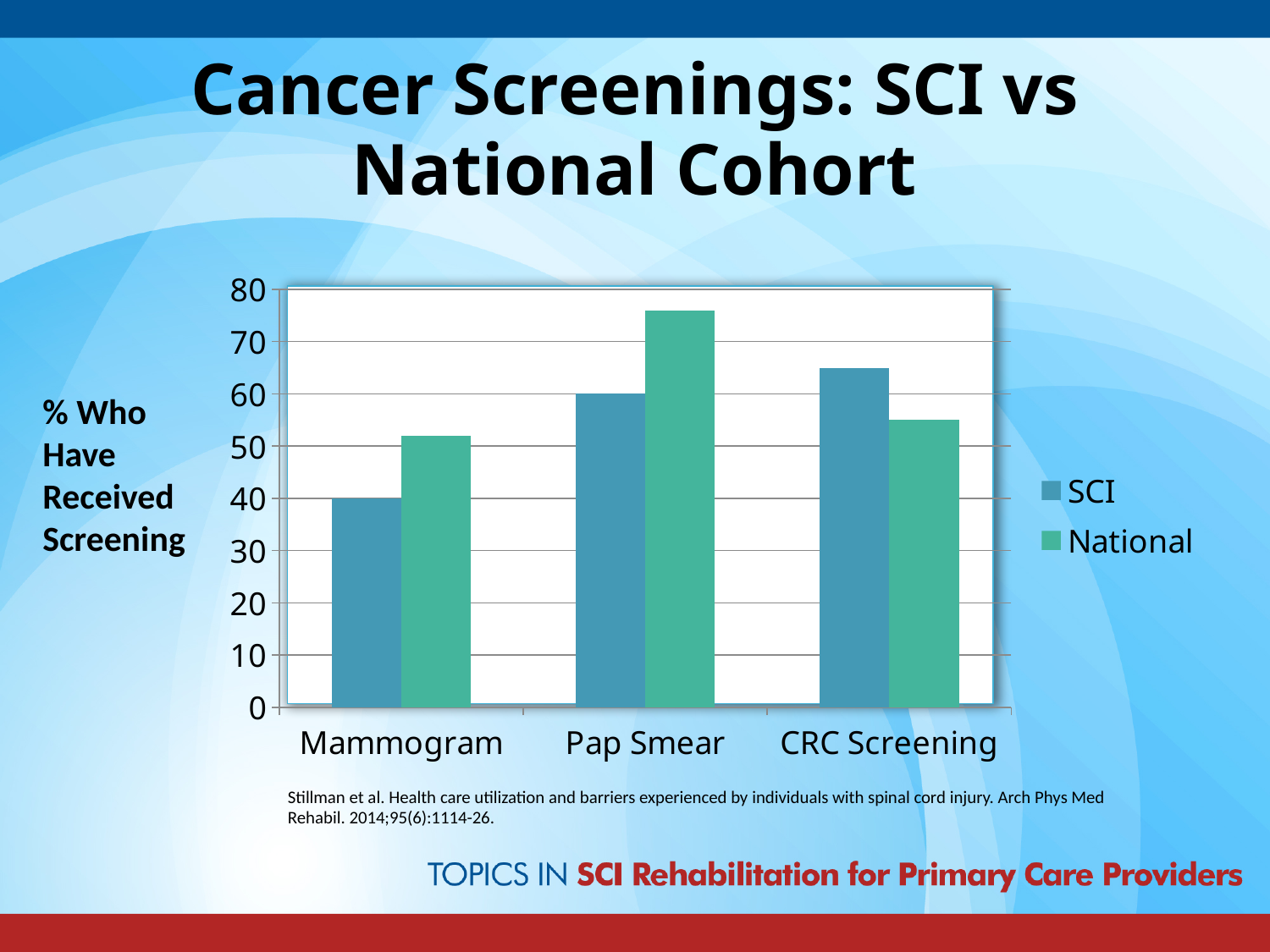
How many series does the legend list? 2 What is the SCI value for Mammogram? 40 How many screening categories are shown on the x axis? 3 Which category has the lowest SCI value? Mammogram Is the National value for Pap Smear greater or less than 70? greater For CRC Screening, which is larger, the SCI value or the National value? SCI Which category has the highest National value? Pap Smear What kind of chart is shown on the slide? bar chart What is the SCI value for Pap Smear? 60 What is the title of the chart on the slide? Cancer Screenings: SCI vs National Cohort Is the National value for Mammogram greater or less than 50? greater Is the SCI value for CRC Screening greater or less than 60? greater